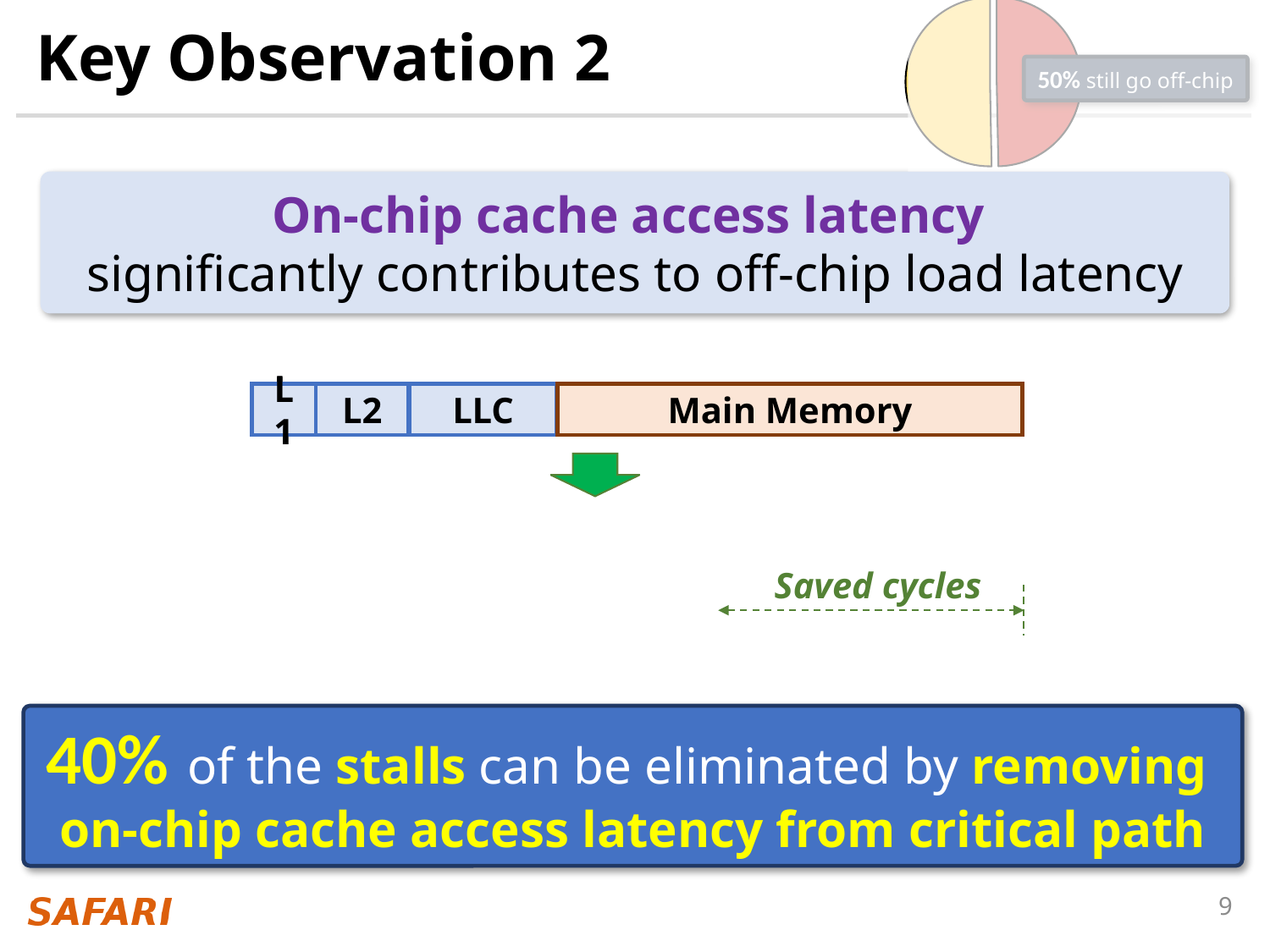
In the pie chart in the top right corner, what colour is the slice labeled "50% still go off-chip"? red In the pie chart in the top right corner, what share of loads is labeled as still going off-chip? 50% What does the label attached to the pie chart in the top right corner say? 50% still go off-chip What kind of chart is shown in the top right corner of the slide? pie chart How many slices does the pie chart in the top right corner have? 2